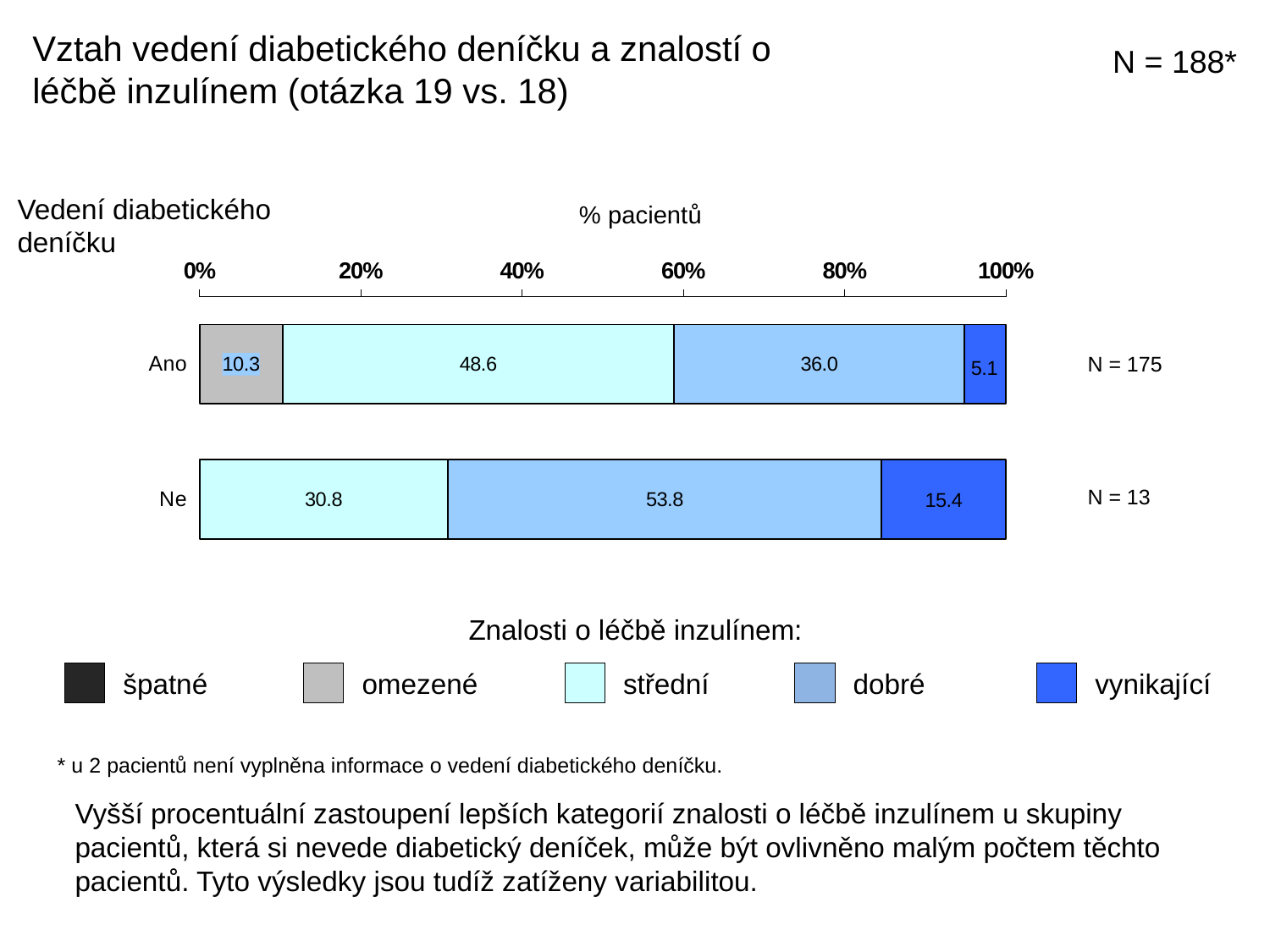
What is the N value shown next to the 'Ano' bar? N = 175 Which bar has the larger 'dobré' segment, 'Ano' or 'Ne'? Ne What is the value of the 'dobré' segment for the 'Ne' bar? 53.8 How many entries does the legend list? 5 What is the difference between the 'vynikající' values for 'Ne' and 'Ano'? 10.3 What is the value of the 'omezené' segment for the 'Ano' bar? 10.3 Which segment is the smallest in the 'Ano' bar? vynikající What type of chart is shown on the slide? stacked bar chart Which segment is the largest in the 'Ne' bar? dobré How many bars (categories) are plotted in the chart? 2 What is the value of the 'střední' segment for the 'Ano' bar? 48.6 What is the value of the 'vynikající' segment for the 'Ano' bar? 5.1